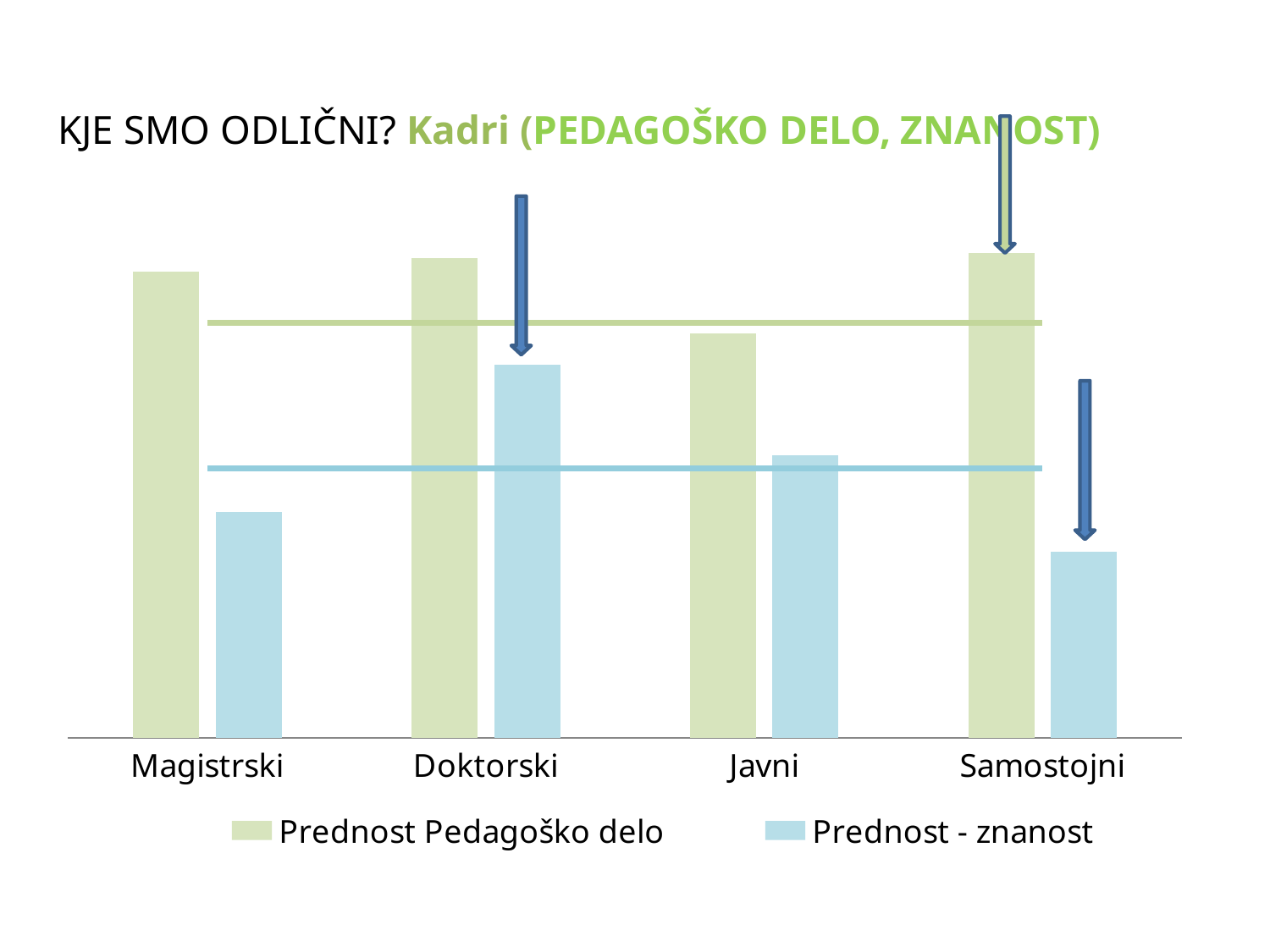
Which colour represents the series Prednost - znanost in the chart? light blue Which category has the lowest value for the series Prednost - znanost? Samostojni Which category has the lowest value for the series Prednost Pedagoško delo? Javni For Javni, which series has the larger value: Prednost Pedagoško delo or Prednost - znanost? Prednost Pedagoško delo Which category has the highest value for the series Prednost - znanost? Doktorski For the series Prednost - znanost, which category has the larger value: Doktorski or Javni? Doktorski For the series Prednost Pedagoško delo, which category has the larger value: Magistrski or Javni? Magistrski How many categories are shown on the x axis of the chart? 4 What are the two series names listed in the chart's legend? Prednost Pedagoško delo; Prednost - znanost What kind of chart is shown on the slide? combination bar and line chart How many series does the chart's legend list? 2